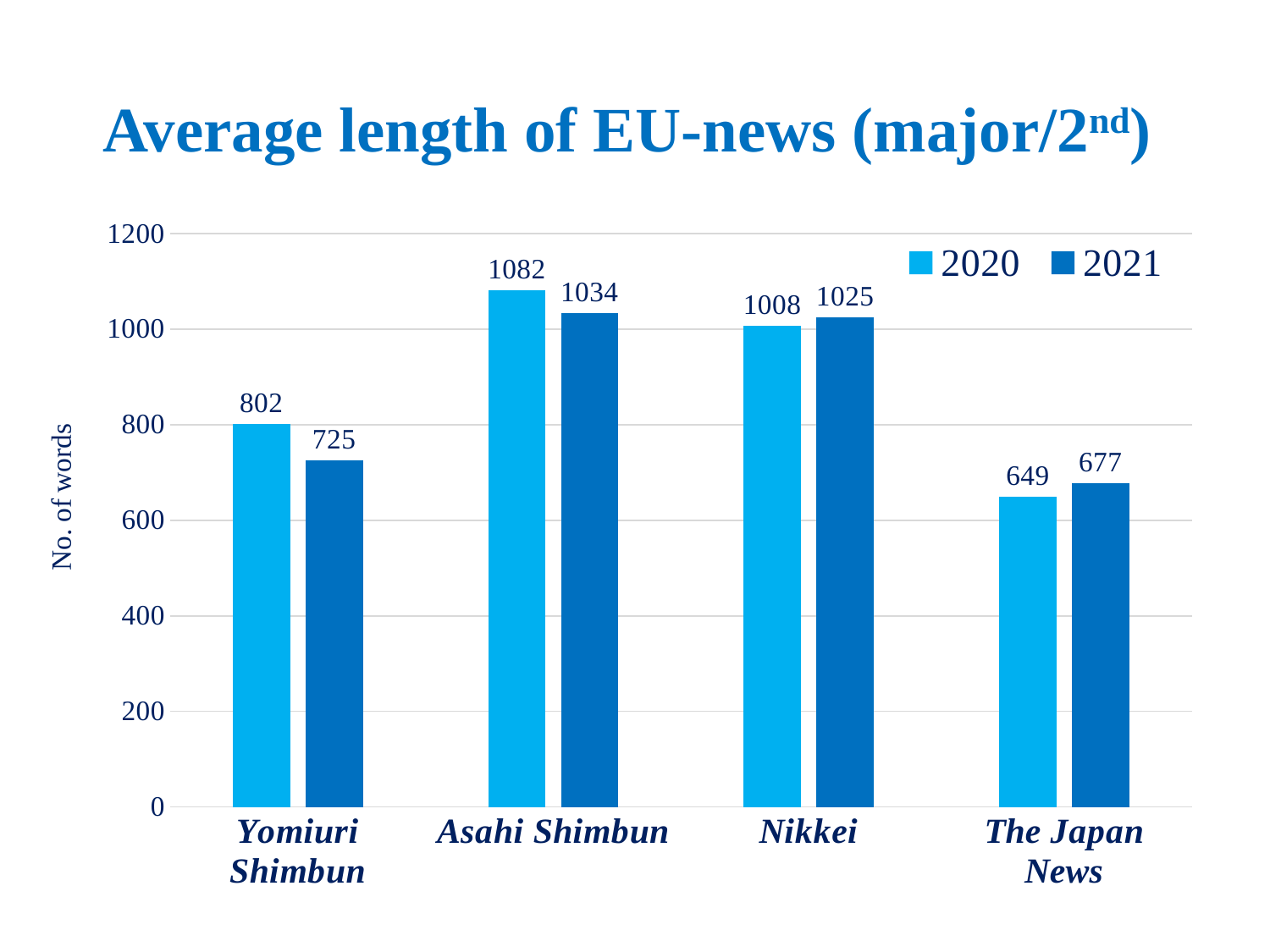
What is the difference between the 2020 values for Asahi Shimbun and Nikkei? 74 What is the 2021 value for Yomiuri Shimbun? 725 How many series does the legend list? 2 What kind of chart is shown on the slide? Bar chart What is the 2020 value for Asahi Shimbun? 1082 Which newspaper has the highest 2020 value? Asahi Shimbun What is the label of the vertical axis? No. of words How many newspapers are shown on the x axis? 4 What is the difference between the 2020 and 2021 values for Yomiuri Shimbun? 77 What is the 2021 value for The Japan News? 677 Which newspaper has the lowest 2021 value? The Japan News Which is larger for Nikkei, the 2020 value or the 2021 value? 2021